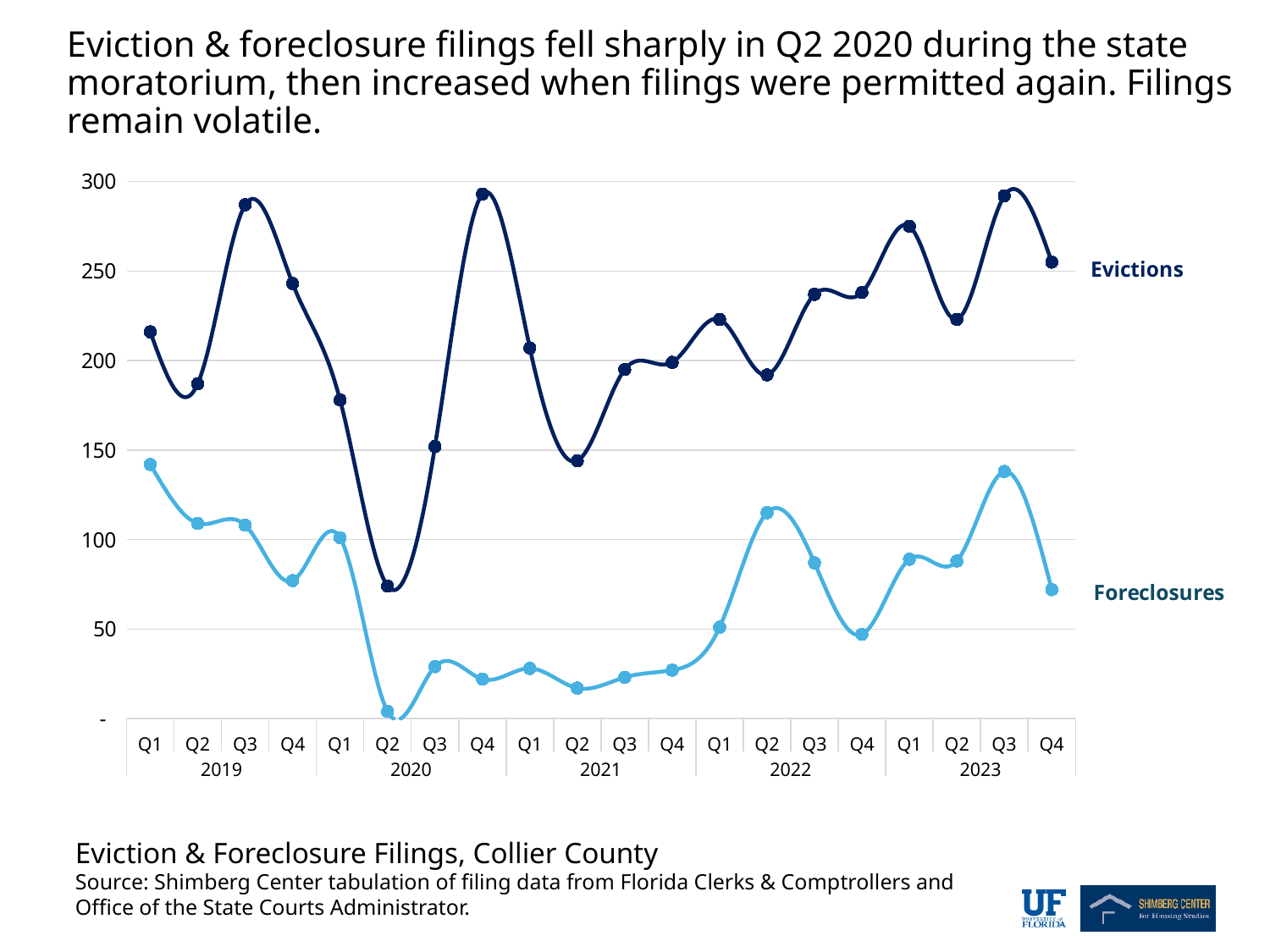
In which quarter is the Foreclosures line at its lowest? Q2 2020 What kind of chart is shown on the slide? Line chart Is the value for Evictions in Q2 2020 greater or less than 100? less In which quarter is the Evictions line at its lowest? Q2 2020 Do Foreclosures rise or fall from Q1 2019 to Q2 2020? Fall How many quarterly data points does each line have? 20 Is the value for Foreclosures in Q2 2022 greater or less than 100? greater What is the title of the chart given below the plot? Eviction & Foreclosure Filings, Collier County How many series are plotted on the chart? 2 Which series has the higher value in Q1 2019, Evictions or Foreclosures? Evictions Is the value for Evictions in Q1 2019 greater or less than 200? greater